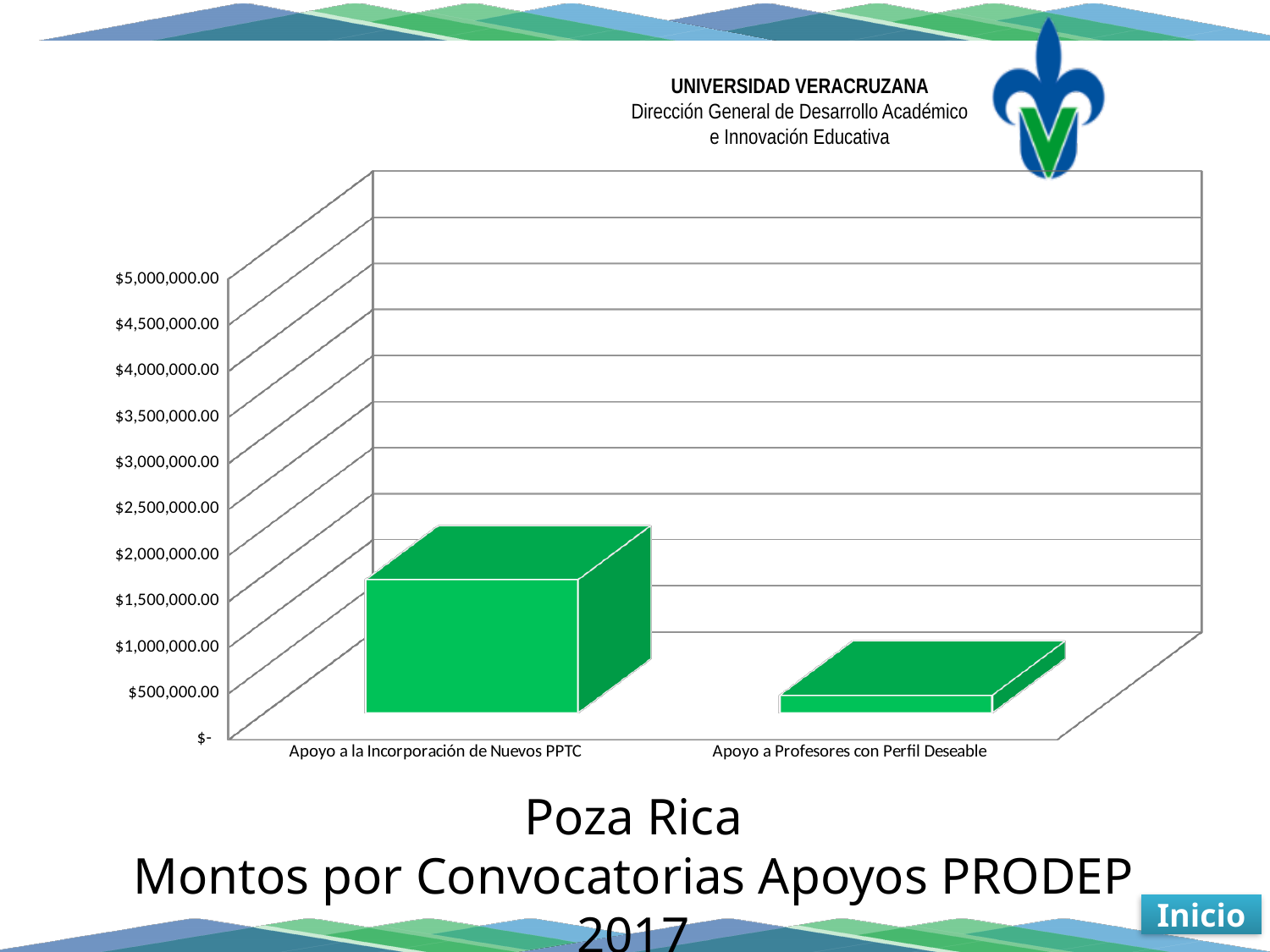
Which is larger, the value for Apoyo a la Incorporación de Nuevos PPTC or the value for Apoyo a Profesores con Perfil Deseable? Apoyo a la Incorporación de Nuevos PPTC Is the value for Apoyo a la Incorporación de Nuevos PPTC greater or less than $3,000,000.00? less Is the value for Apoyo a la Incorporación de Nuevos PPTC greater or less than $1,000,000.00? greater Which category has the highest value? Apoyo a la Incorporación de Nuevos PPTC Which category has the lowest value? Apoyo a Profesores con Perfil Deseable What city is named in the chart title? Poza Rica Is the value for Apoyo a Profesores con Perfil Deseable greater or less than $1,000,000.00? less Do the values rise or fall from left to right along the x axis? fall How many categories are plotted on the chart? 2 What kind of chart is shown on the slide? bar chart What is the highest value shown on the vertical axis? $5,000,000.00